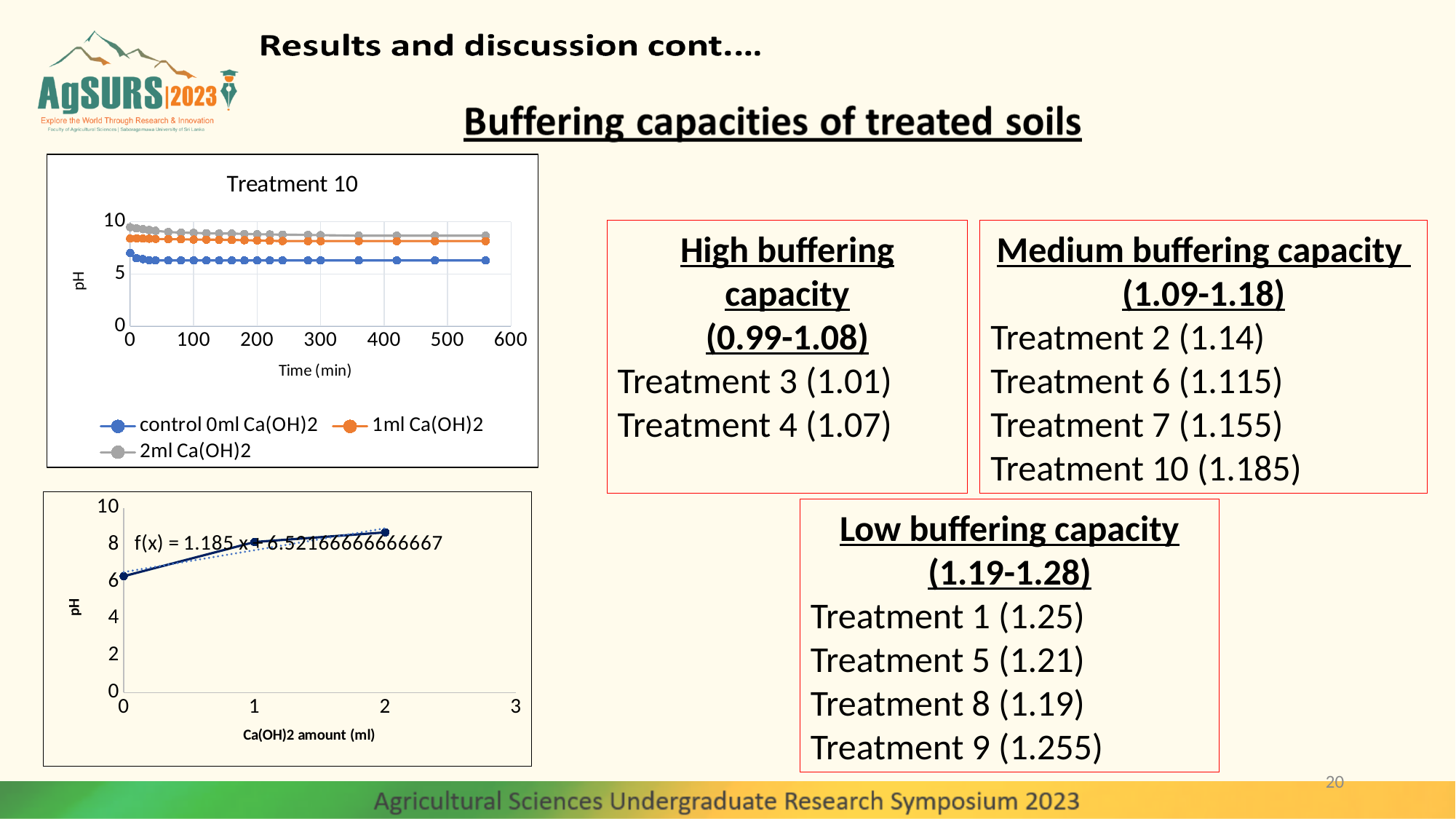
How many series does the legend of the 'Treatment 10' chart list? 3 In the 'Treatment 10' chart, which series has the highest pH values? 2ml Ca(OH)2 What is the trendline equation shown on the bottom-left chart of pH against Ca(OH)2 amount? f(x) = 1.185 x + 6.52166666666667 What is the x-axis label of the bottom-left chart? Ca(OH)2 amount (ml) In the 'Treatment 10' chart, which series is larger in pH: 1ml Ca(OH)2 or control 0ml Ca(OH)2? 1ml Ca(OH)2 What is the x-axis label of the 'Treatment 10' chart? Time (min) On the bottom-left chart, does pH rise or fall as the Ca(OH)2 amount increases? rise In the 'Treatment 10' chart, is the pH of the control 0ml Ca(OH)2 series greater or less than 5? greater In the 'Treatment 10' chart, which series has the lowest pH values? control 0ml Ca(OH)2 How many data points are plotted on the bottom-left chart of pH against Ca(OH)2 amount? 3 What kind of chart is the 'Treatment 10' chart at the top left of the slide? line chart In the 'Treatment 10' chart, is the pH of the 2ml Ca(OH)2 series greater or less than 10? less